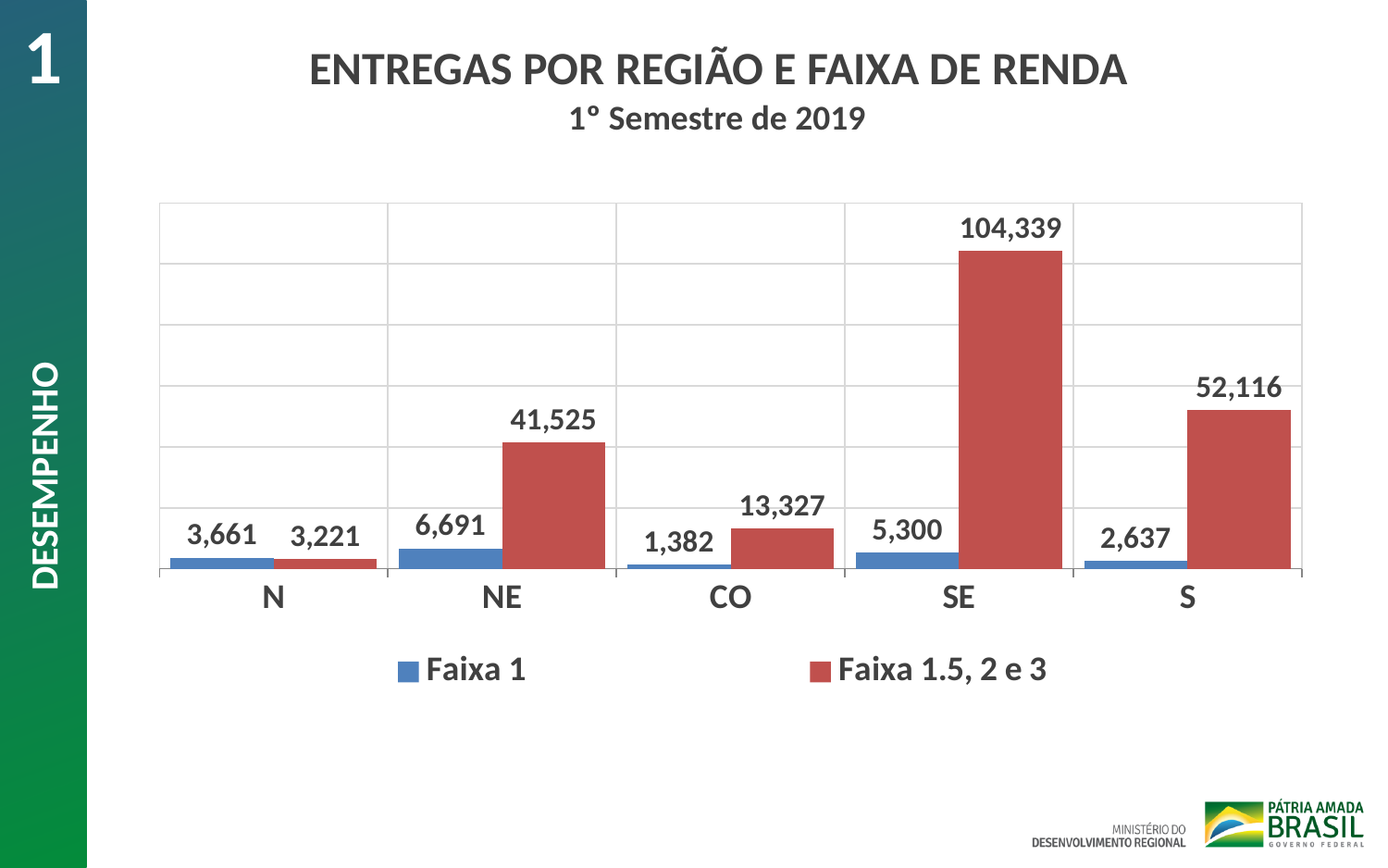
What is the difference between the Faixa 1.5, 2 e 3 value and the Faixa 1 value in the SE region? 99,039 What is the value for Faixa 1.5, 2 e 3 in the CO region? 13,327 What is the subtitle shown under the chart title? 1° Semestre de 2019 Which region has the lowest value for Faixa 1? CO What is the value for Faixa 1.5, 2 e 3 in the SE region? 104,339 How many regions are shown on the x axis? 5 What is the value for Faixa 1 in the S region? 2,637 Which region has the highest value for Faixa 1.5, 2 e 3? SE What kind of chart is shown on the slide? Bar chart How many series does the legend list? 2 In the N region, which is larger: Faixa 1 or Faixa 1.5, 2 e 3? Faixa 1 What is the value for Faixa 1 in the NE region? 6,691